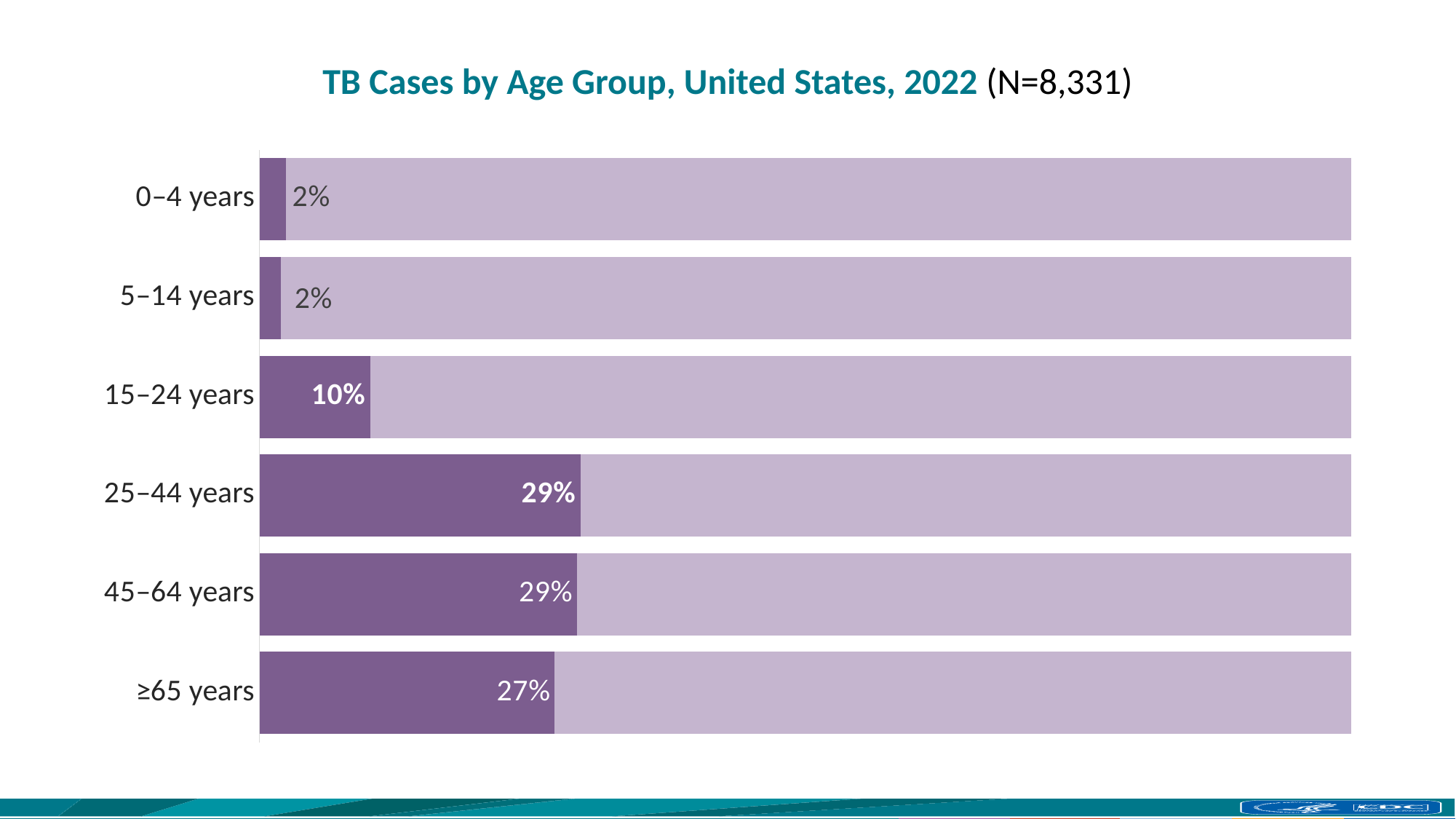
What percentage of TB cases were in the ≥65 years age group? 27% How many age groups are shown in the chart? 6 What percentage of TB cases were in the 0–4 years age group? 2% What percentage of TB cases were in the 25–44 years age group? 29% What is the difference in percentage points between the 25–44 years and 15–24 years age groups? 19 percentage points What is the highest percentage shown for any age group? 29% What is the lowest percentage shown for any age group? 2% What percentage of TB cases were in the 45–64 years age group? 29% Which age group has a larger share of TB cases, 45–64 years or ≥65 years? 45–64 years Which age group has a larger share of TB cases, 15–24 years or 25–44 years? 25–44 years What kind of chart is shown on the slide? Bar chart What percentage of TB cases were in the 15–24 years age group? 10%